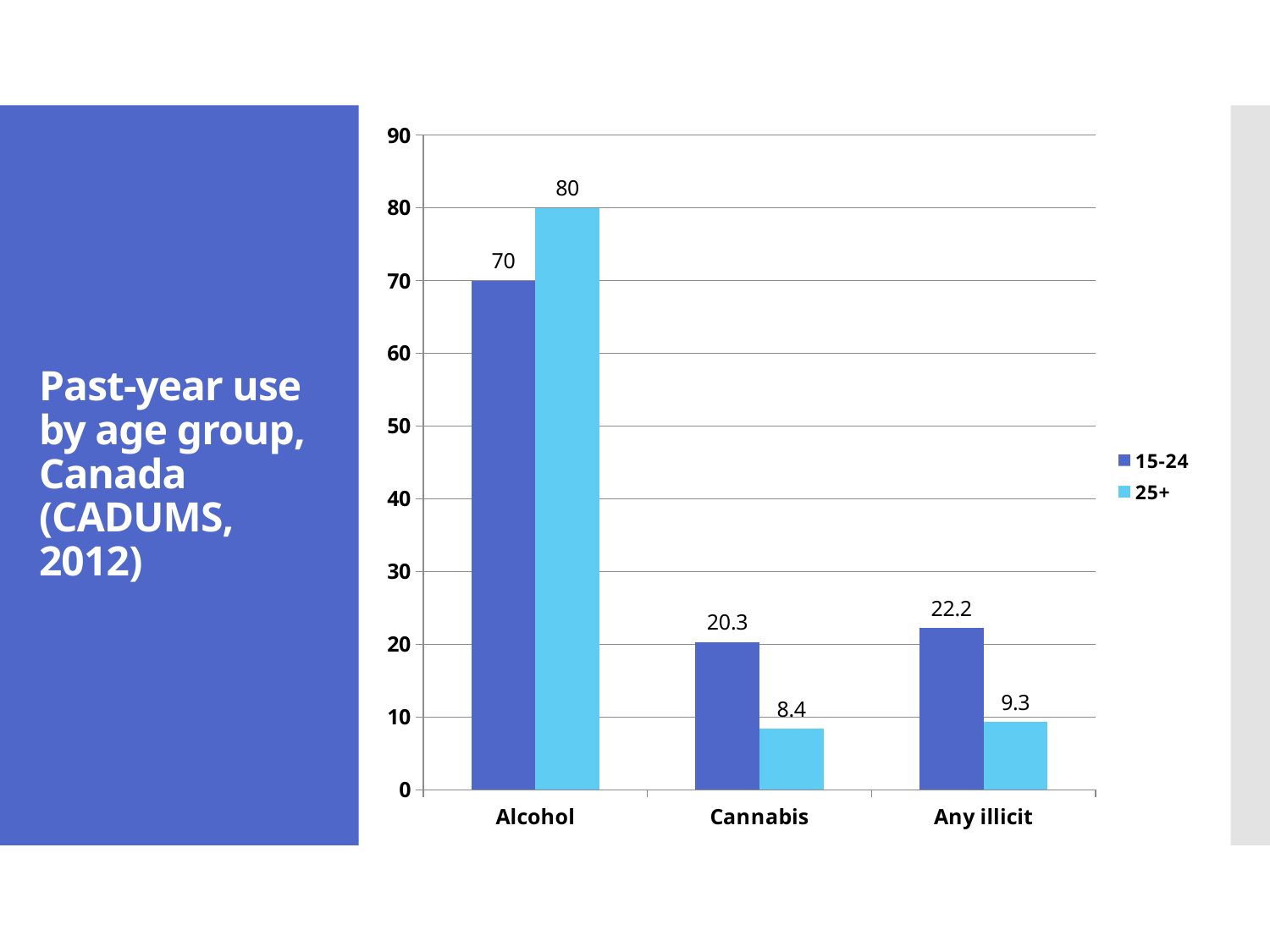
Which category has the highest value in the 25+ series? Alcohol What is the value for Alcohol in the 15-24 series? 70 How many categories are shown on the x axis? 3 What are the two series named in the legend? 15-24 and 25+ What is the value for Cannabis in the 25+ series? 8.4 Which is larger for Cannabis: the 15-24 value or the 25+ value? 15-24 What is the value for Any illicit in the 15-24 series? 22.2 How many series does the legend list? 2 Which category has the lowest value in the 15-24 series? Cannabis What kind of chart is shown on the slide? Bar chart What is the difference between the 15-24 and 25+ values for Any illicit? 12.9 What is the difference between the 25+ and 15-24 values for Alcohol? 10